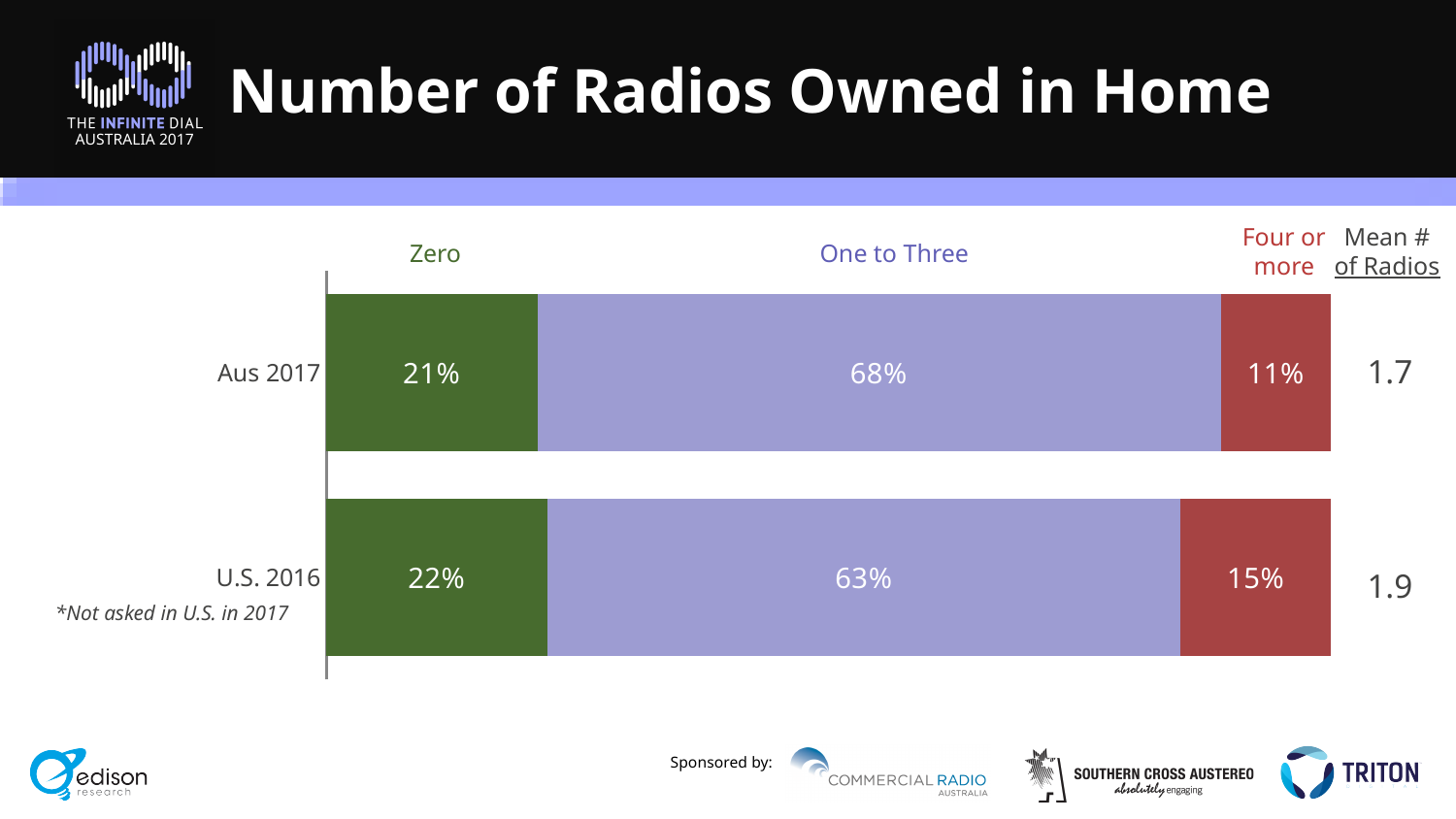
What percentage of Aus 2017 respondents own four or more radios? 11% What type of chart is shown? Stacked bar chart Which segment is the largest for Aus 2017? One to Three What is the difference in percentage points between the 'One to Three' values for Aus 2017 and U.S. 2016? 5 What percentage of U.S. 2016 respondents own one to three radios? 63% How many segments does each bar have? 3 Which has a larger 'Four or more' share, Aus 2017 or U.S. 2016? U.S. 2016 What is the mean number of radios for Aus 2017? 1.7 Which segment is the smallest for U.S. 2016? Four or more What percentage of Aus 2017 respondents own zero radios in the home? 21% What is the mean number of radios for U.S. 2016? 1.9 What is the total of the three segments for the Aus 2017 bar? 100%